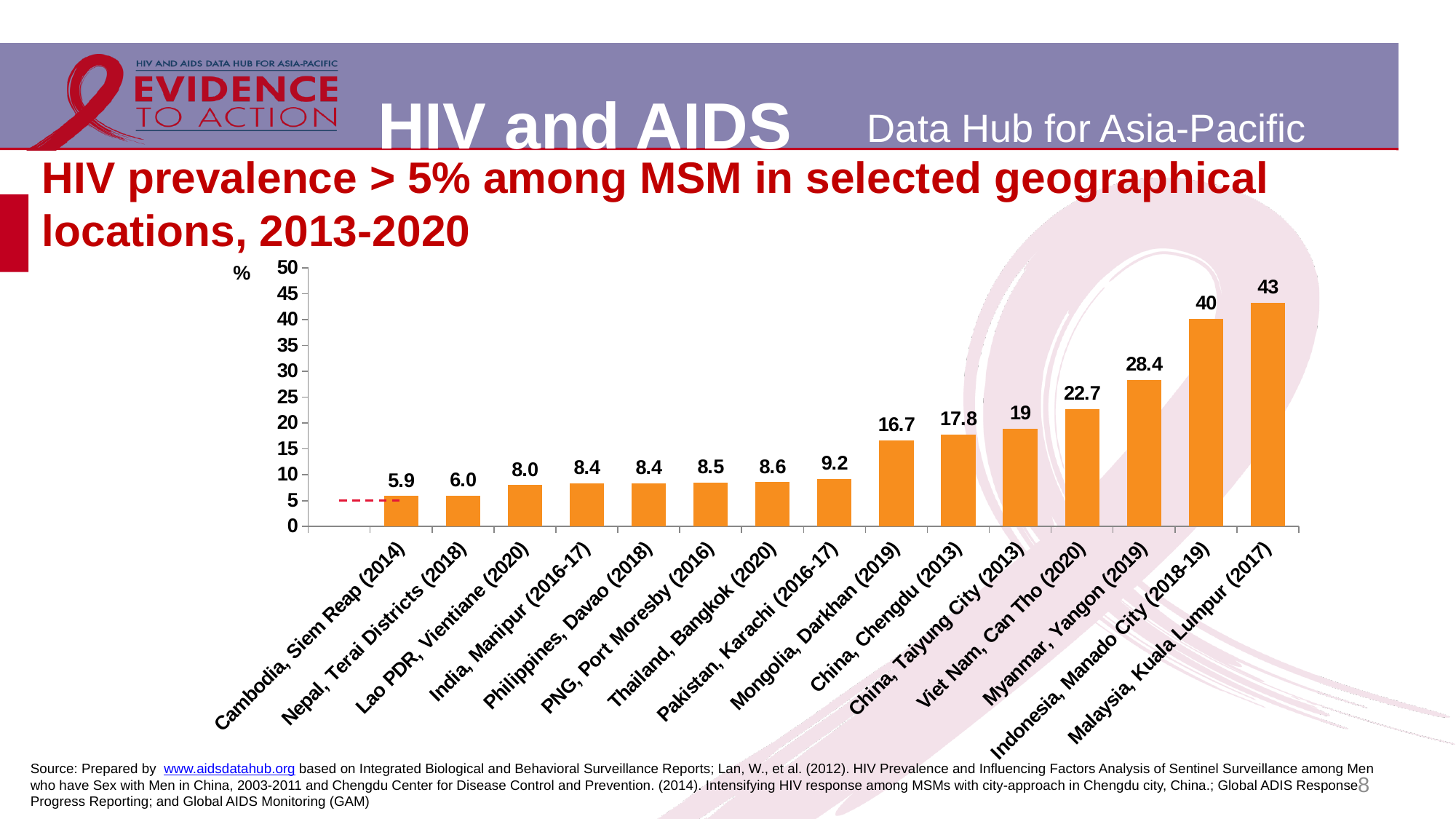
What is the HIV prevalence value shown for Malaysia, Kuala Lumpur (2017)? 43 How many geographical locations are shown in the chart? 15 Is the value for Myanmar, Yangon (2019) greater or less than 25? greater Do the values generally rise or fall from left to right along the x axis? Rise What is the value shown for Mongolia, Darkhan (2019)? 16.7 Which location has the highest HIV prevalence in the chart? Malaysia, Kuala Lumpur (2017) What is the value shown for Viet Nam, Can Tho (2020)? 22.7 What is the difference between the values for Indonesia, Manado City (2018-19) and Myanmar, Yangon (2019)? 11.6 What type of chart is used on this slide? Bar chart Which has a higher value: China, Chengdu (2013) or Pakistan, Karachi (2016-17)? China, Chengdu (2013) What unit is indicated on the y axis of the chart? % Which location has the lowest HIV prevalence in the chart? Cambodia, Siem Reap (2014)